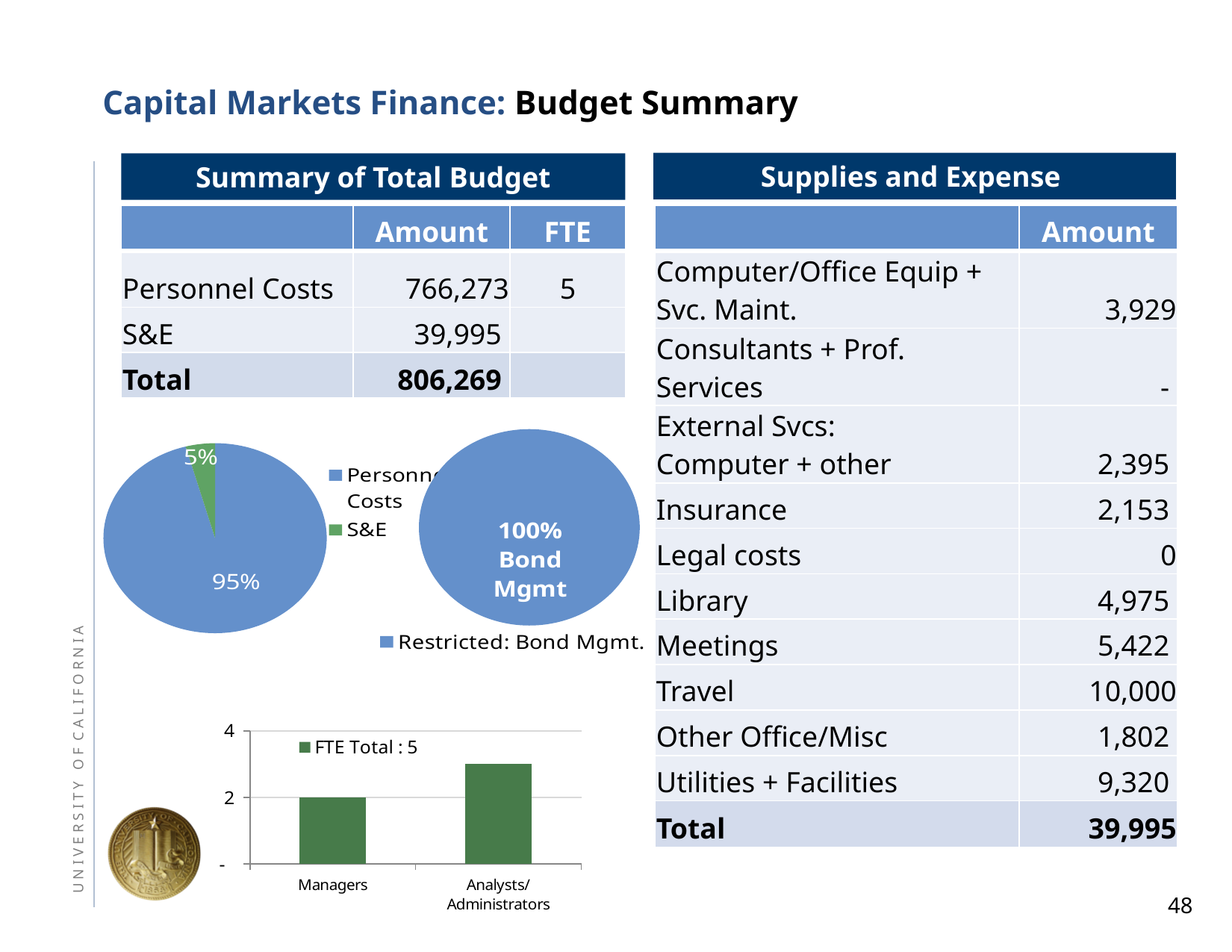
In the pie chart on the left showing Personnel Costs and S&E, what share does S&E have? 5% In the pie chart on the left showing Personnel Costs and S&E, what share does Personnel Costs have? 95% In the bar chart at the bottom of the slide, what is the value for Managers? 2 In the pie chart in the middle of the slide, what is the legend entry? Restricted: Bond Mgmt. In the pie chart on the left showing Personnel Costs and S&E, what colour is the S&E slice? Green In the bar chart at the bottom of the slide, how many categories are shown on the x axis? 2 In the pie chart in the middle of the slide, what percentage is labelled for Bond Mgmt? 100% In the bar chart at the bottom of the slide, which category has the highest value? Analysts/Administrators In the pie chart on the left showing Personnel Costs and S&E, which slice is larger? Personnel Costs In the bar chart at the bottom of the slide, is the value for Analysts/Administrators greater or less than 2? greater What kind of chart is the chart at the bottom of the slide showing Managers and Analysts/Administrators? Bar chart In the pie chart on the left showing Personnel Costs and S&E, how many slices are there? 2